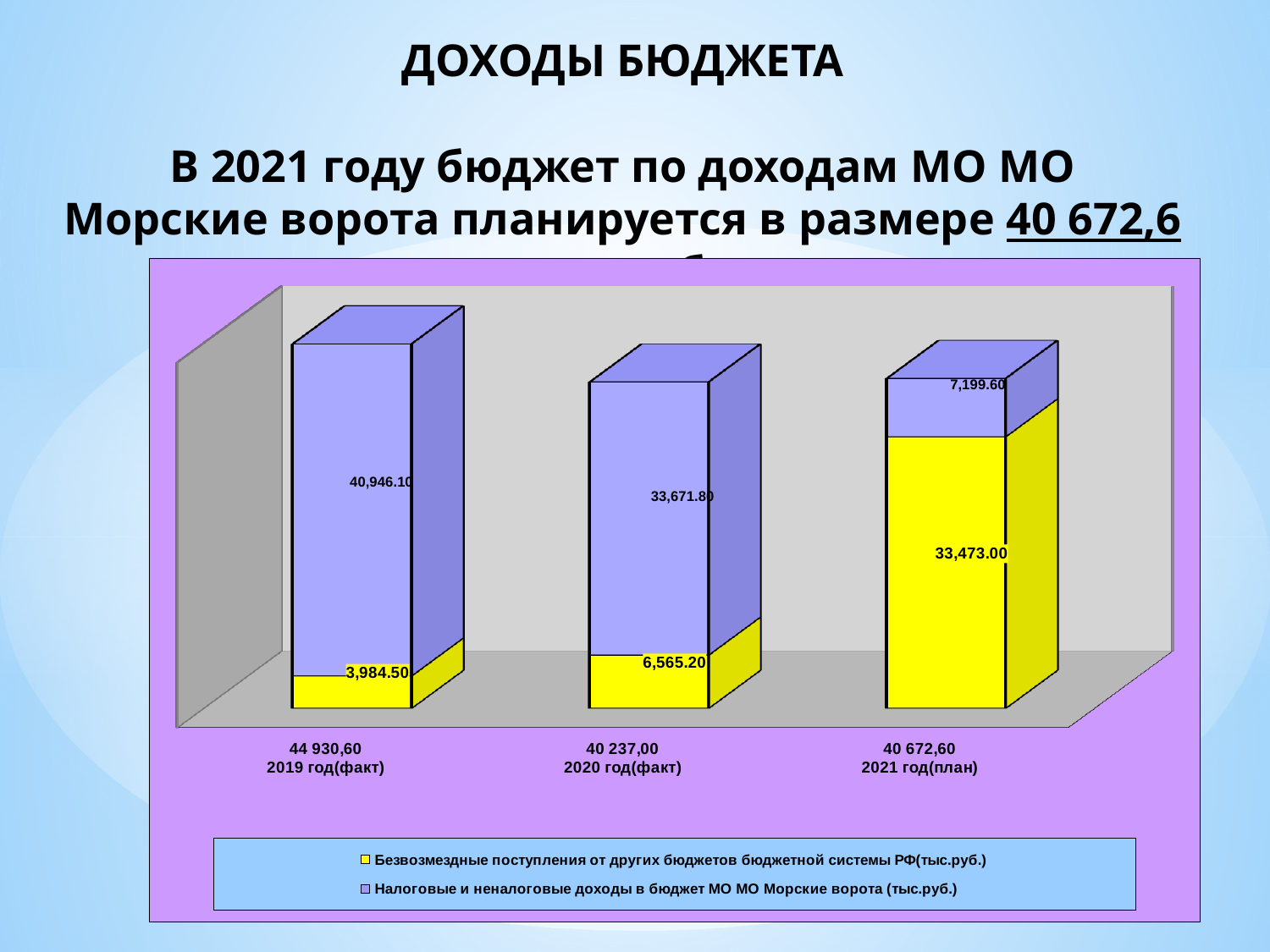
In which year is the 'Безвозмездные поступления' value the lowest? 2019 год(факт) What is the value of 'Безвозмездные поступления' for 2021 год(план)? 33,473.00 How many categories (years) are plotted on the chart? 3 Which is larger in 2021 год(план): 'Безвозмездные поступления' or 'Налоговые и неналоговые доходы'? Безвозмездные поступления What is the value of 'Налоговые и неналоговые доходы' for 2019 год(факт)? 40,946.10 How many series does the legend list? 2 What is the value of 'Безвозмездные поступления' for 2020 год(факт)? 6,565.20 What type of chart is shown on the slide? stacked bar chart What is the value of 'Налоговые и неналоговые доходы' for 2021 год(план)? 7,199.60 What is the total budget income shown for 2020 год(факт)? 40 237,00 In which year is the 'Налоговые и неналоговые доходы' value the highest? 2019 год(факт) What is the difference between the 'Безвозмездные поступления' values for 2020 год(факт) and 2019 год(факт)? 2,580.70